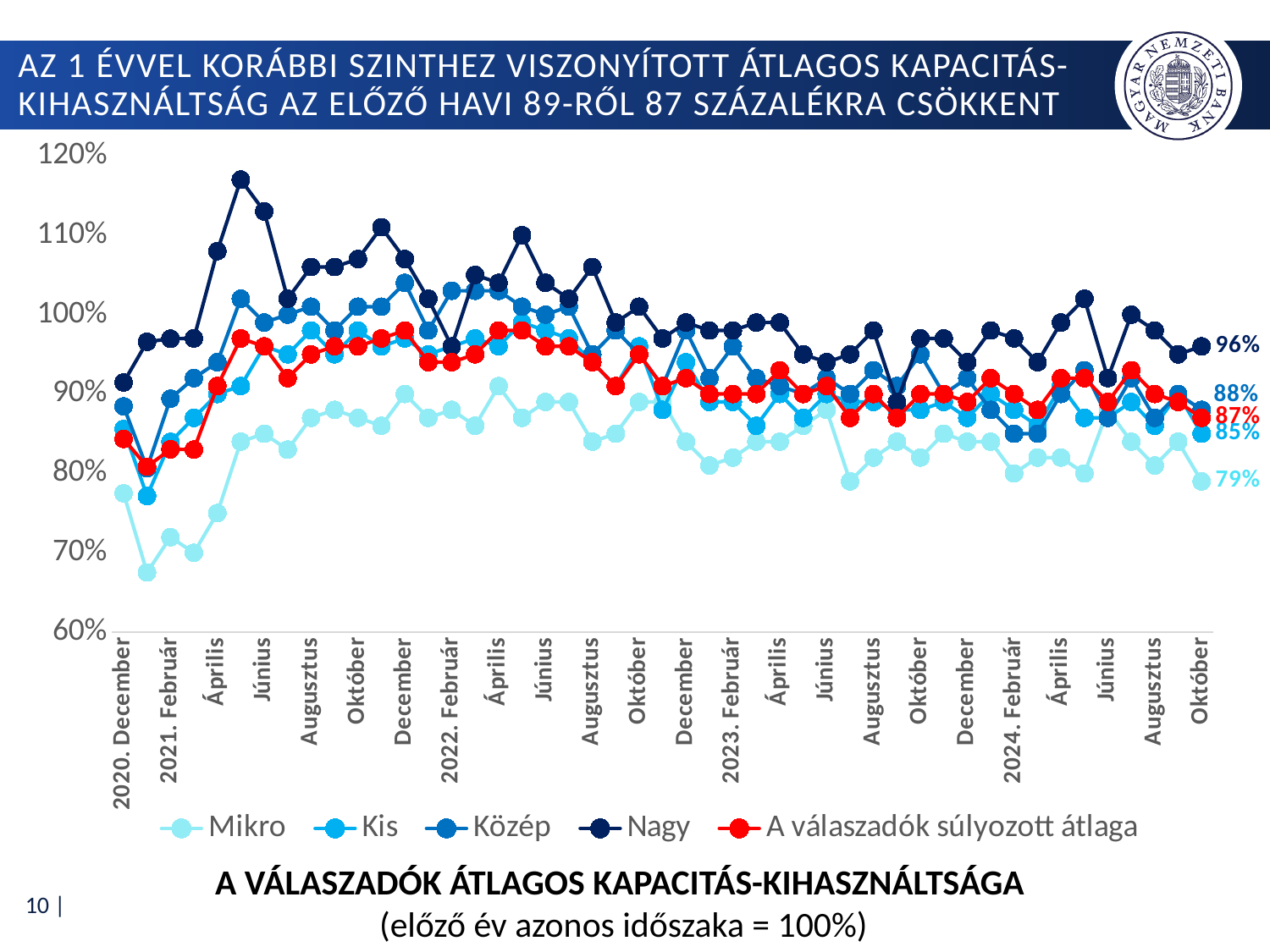
What is the value for Nagy at the last point (2024 Október)? 96% What is the value for Kis at the last point (2024 Október)? 85% Which series has the lowest value at the last point (2024 Október)? Mikro What kind of chart is shown on the slide? line chart At the last point (2024 Október), which is larger: Közép or Kis? Közép Is the value for Nagy in 2021 Június greater or less than 110%? greater What is the value of 'A válaszadók súlyozott átlaga' at the last point (2024 Október)? 87% Which series has the highest value at the last point (2024 Október)? Nagy What is the difference between the Nagy and Mikro values at the last point (2024 Október)? 17 percentage points How many series does the legend list? 5 What is the value for Mikro at the last point (2024 Október)? 79%